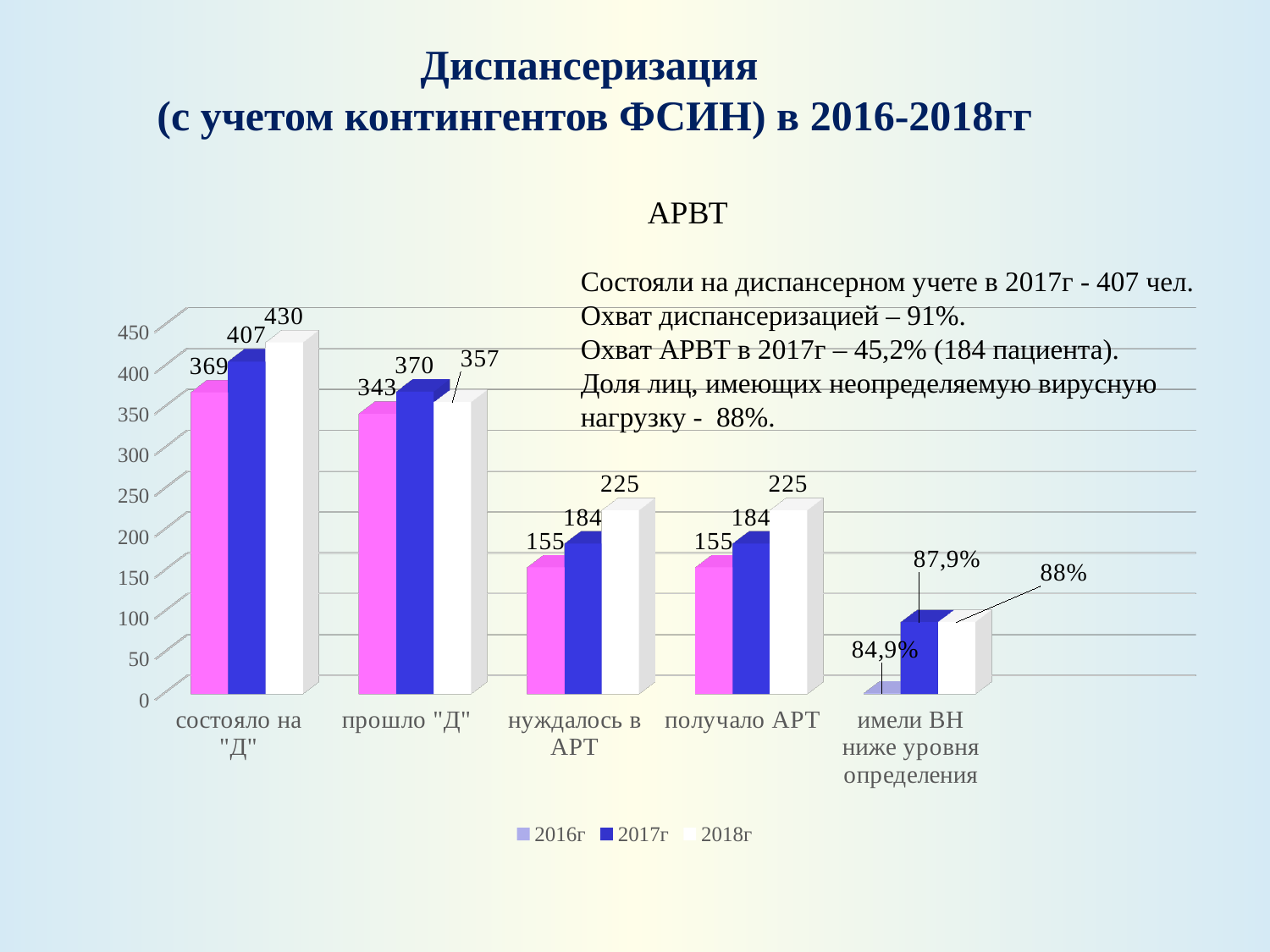
What is the value for 2018г in the category имели ВН ниже уровня определения? 88% Which is larger in the category прошло "Д": the value for 2017г or for 2018г? 2017г What is the value for 2017г in the category состояло на "Д"? 407 What is the value for 2018г in the category прошло "Д"? 357 Which category has the highest value for 2018г? состояло на "Д" What kind of chart is shown? bar chart How many series does the legend list? 3 How many categories are shown on the x axis? 5 What is the title of the chart? АРВТ Which category has the lowest value for 2017г? имели ВН ниже уровня определения What is the value for 2016г in the category нуждалось в АРТ? 155 What is the difference between the 2018г and 2016г values in the category состояло на "Д"? 61